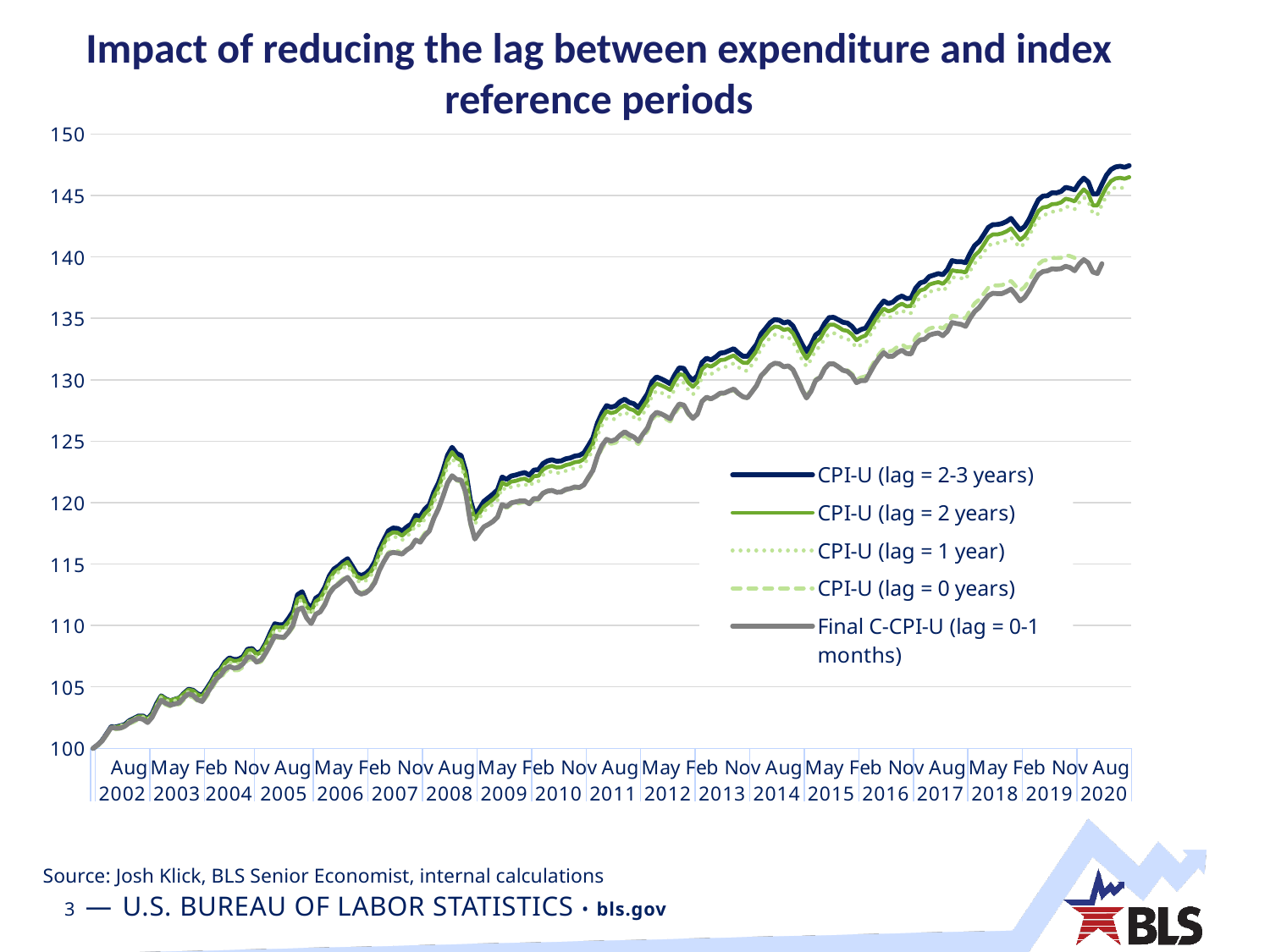
How many series does the legend list? 5 Do the index values generally rise or fall from 2002 to 2020? rise Is the value for CPI-U (lag = 2-3 years) in Aug 2020 greater or less than 145? greater At Aug 2020, which is larger: CPI-U (lag = 2-3 years) or Final C-CPI-U (lag = 0-1 months)? CPI-U (lag = 2-3 years) Which series has the lowest value at the end of the period (Aug 2020)? Final C-CPI-U (lag = 0-1 months) Which series has the highest value at the end of the period (Aug 2020)? CPI-U (lag = 2-3 years) What kind of chart is shown on the slide? line chart What value do all the series start at in 2002? 100 Is the value for Final C-CPI-U (lag = 0-1 months) in Aug 2015 greater or less than 130? greater What is the title of the chart? Impact of reducing the lag between expenditure and index reference periods Which series is drawn with a dashed line? CPI-U (lag = 0 years)